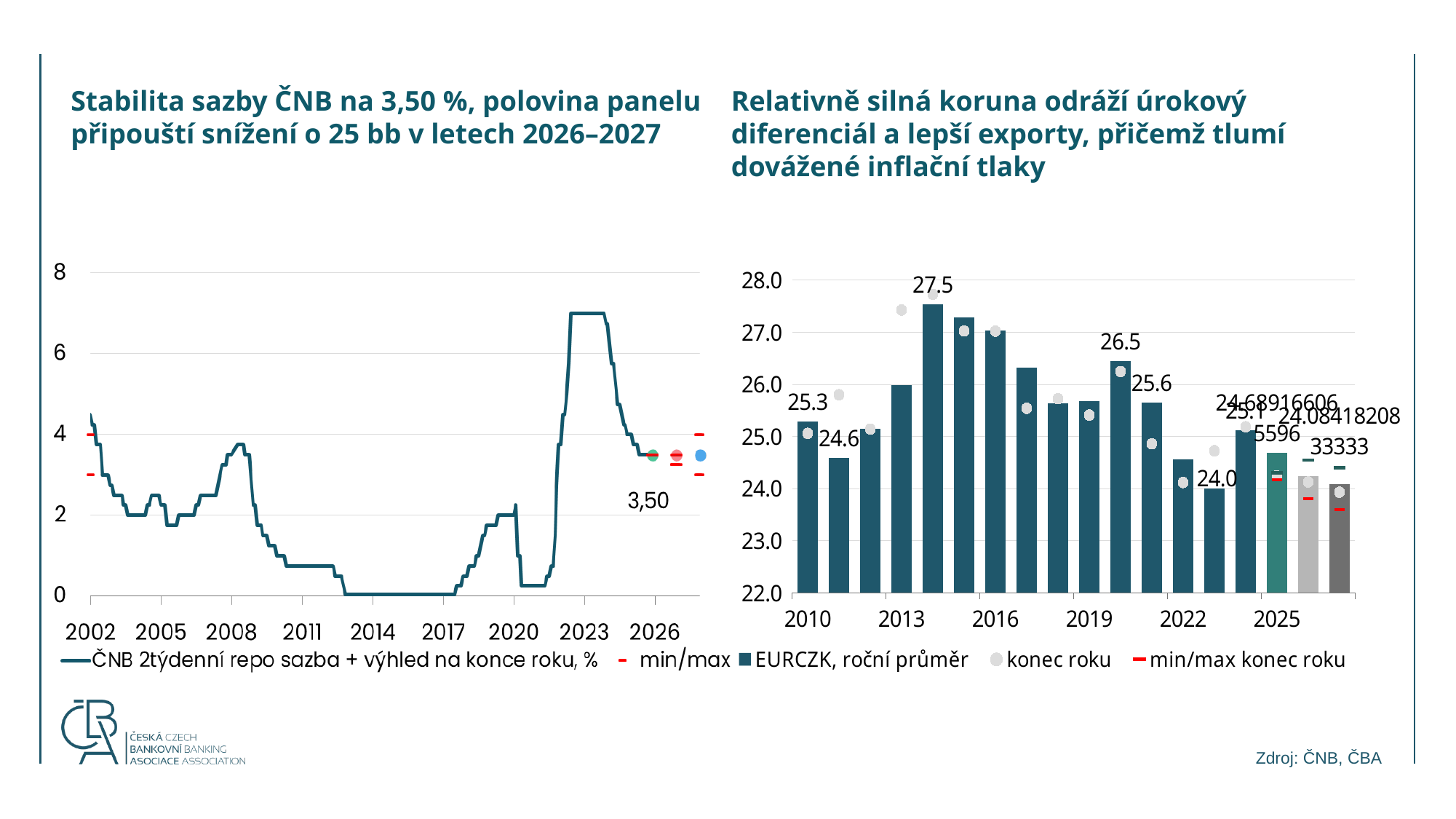
In the right-hand chart, what is the difference between the 2020 value (26.5) and the 2021 value (25.6)? 0.9 In the right-hand chart, what is the EURCZK annual average labelled for 2020? 26.5 How many series does the legend of the right-hand chart list? 3 What kind of chart is the left-hand chart (ČNB repo sazba)? line chart In the right-hand chart, which year has the highest EURCZK annual average bar? 2014 What kind of chart is the right-hand chart (EURCZK)? bar chart In the right-hand chart, what is the EURCZK annual average labelled for 2023? 24.0 In the right-hand chart, which year has the larger EURCZK annual average, 2010 or 2011? 2010 In the right-hand chart, what is the EURCZK annual average labelled for 2010? 25.3 In the right-hand chart, what is the EURCZK annual average labelled for 2014? 27.5 In the left-hand chart, what value is printed as the data label near 2026? 3,50 In the right-hand chart, is the EURCZK annual average bar for 2016 greater or less than 26.0? greater